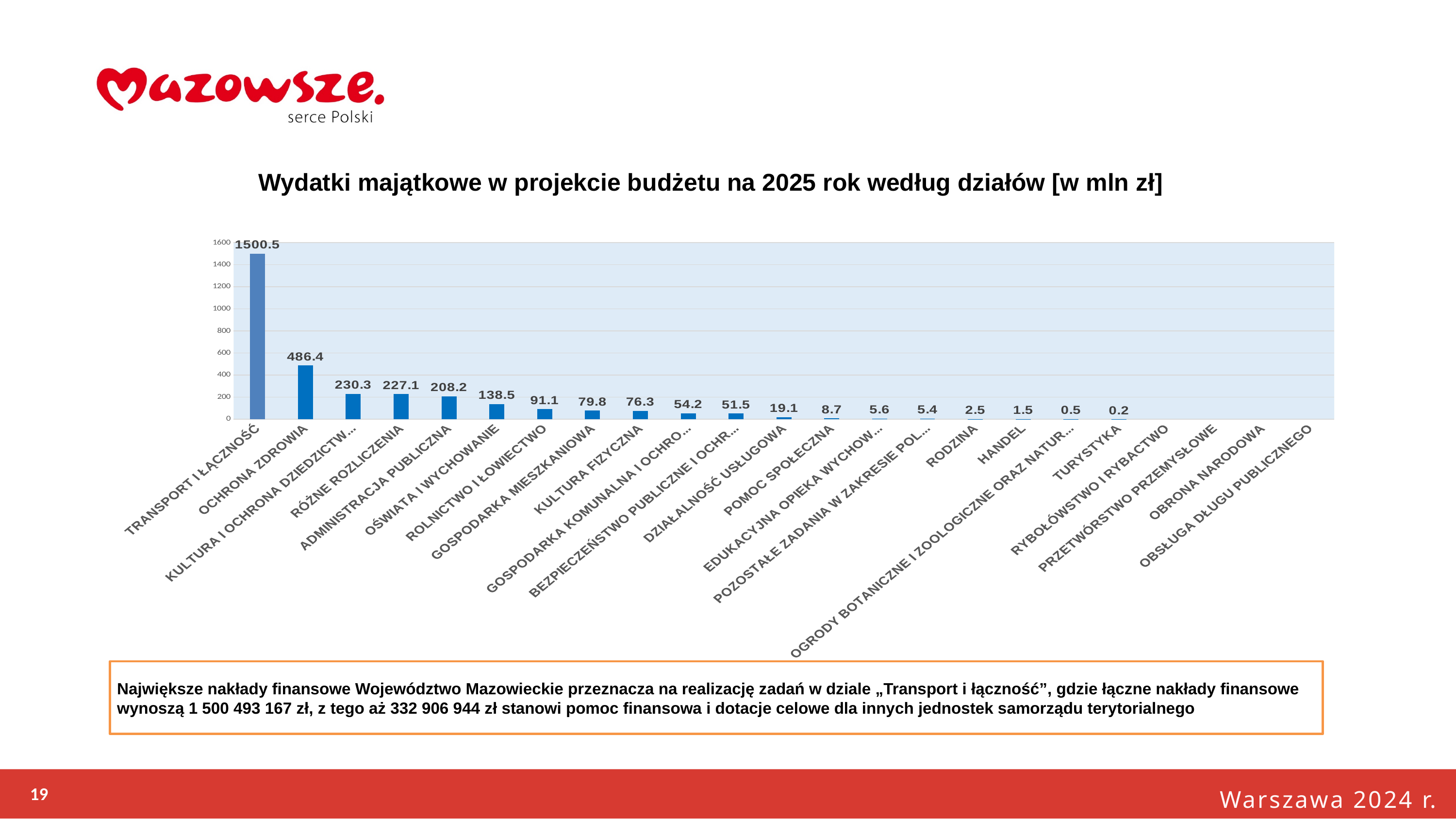
What is the difference between the values for GOSPODARKA MIESZKANIOWA and KULTURA FIZYCZNA? 3.5 What kind of chart is shown on the slide? bar chart Which is larger, RÓŻNE ROZLICZENIA or ADMINISTRACJA PUBLICZNA? RÓŻNE ROZLICZENIA Do the values rise or fall from left to right along the x axis? fall What is the value for RODZINA? 2.5 Is the value for OCHRONA ZDROWIA greater or less than 400? greater What is the value for TRANSPORT I ŁĄCZNOŚĆ? 1500.5 What is the value for OŚWIATA I WYCHOWANIE? 138.5 What is the difference between the values for TRANSPORT I ŁĄCZNOŚĆ and OCHRONA ZDROWIA? 1014.1 Which category has the highest value? TRANSPORT I ŁĄCZNOŚĆ What is the value for TURYSTYKA? 0.2 What is the value for OCHRONA ZDROWIA? 486.4